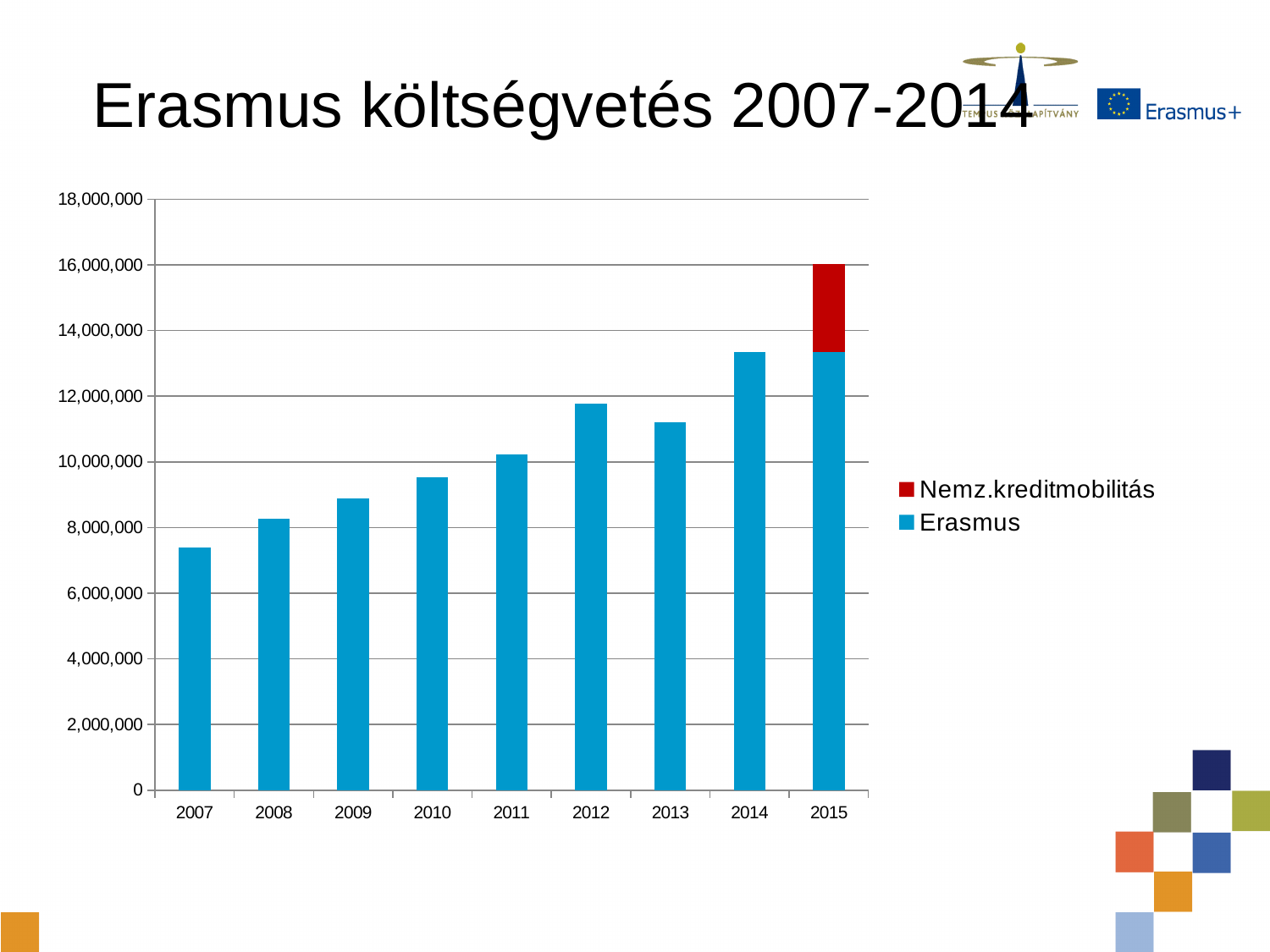
Is the total value for 2015 greater or less than 14,000,000? greater How many series does the chart's legend list? 2 How many years are shown on the x axis of the chart? 9 Which year is the only one with a Nemz.kreditmobilitás segment in the chart? 2015 Is the value for 2013 greater or less than 12,000,000? less Is the value for 2007 greater or less than 8,000,000? less Which year has the highest total bar in the chart? 2015 Which year has the larger bar, 2012 or 2013? 2012 What kind of chart is shown on the slide? bar chart Which year has the lowest total bar in the chart? 2007 Do the Erasmus values generally rise or fall from 2007 to 2014? rise